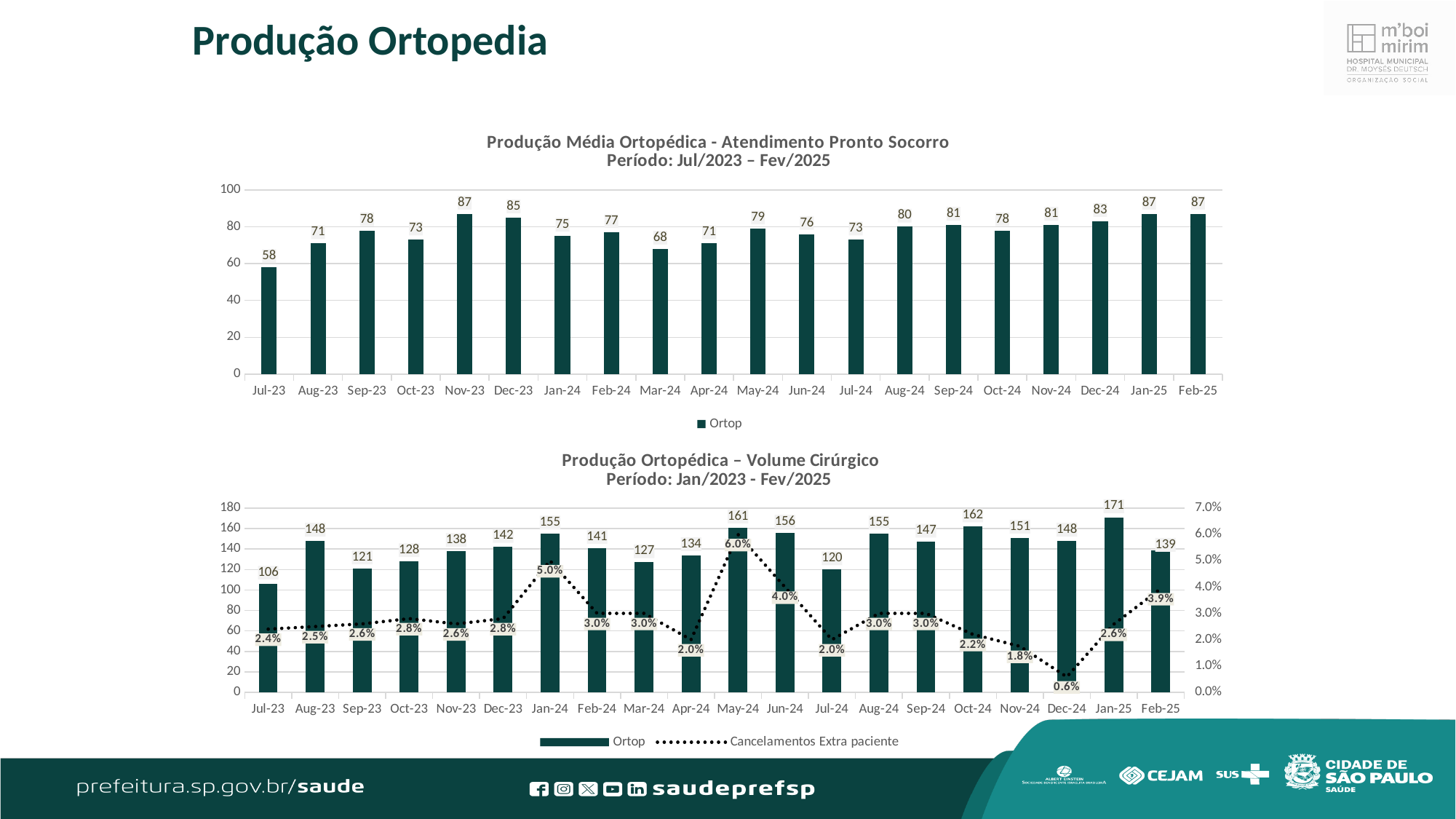
In the bottom chart (Produção Ortopédica – Volume Cirúrgico), in which month does the Cancelamentos Extra paciente line reach its highest value? May-24 In the bottom chart (Produção Ortopédica – Volume Cirúrgico), how many series does the legend list? 2 In the top chart (Produção Média Ortopédica - Atendimento Pronto Socorro), how many months are plotted? 20 In the top chart (Produção Média Ortopédica - Atendimento Pronto Socorro), what is the difference between the values for Dec-23 and Mar-24? 17 In the top chart (Produção Média Ortopédica - Atendimento Pronto Socorro), is the value for Aug-24 larger or smaller than the value for Jul-24? larger In the bottom chart (Produção Ortopédica – Volume Cirúrgico), which month has the lowest Ortop bar? Jul-23 In the top chart (Produção Média Ortopédica - Atendimento Pronto Socorro), which month has the lowest value? Jul-23 In the bottom chart (Produção Ortopédica – Volume Cirúrgico), which month has the highest Ortop bar? Jan-25 In the bottom chart (Produção Ortopédica – Volume Cirúrgico), what is the Cancelamentos Extra paciente value for Dec-24? 0.6% What kind of chart is the top chart (Produção Média Ortopédica - Atendimento Pronto Socorro)? bar chart In the bottom chart (Produção Ortopédica – Volume Cirúrgico), what is the Ortop value for May-24? 161 In the top chart (Produção Média Ortopédica - Atendimento Pronto Socorro), what is the value for Nov-23? 87